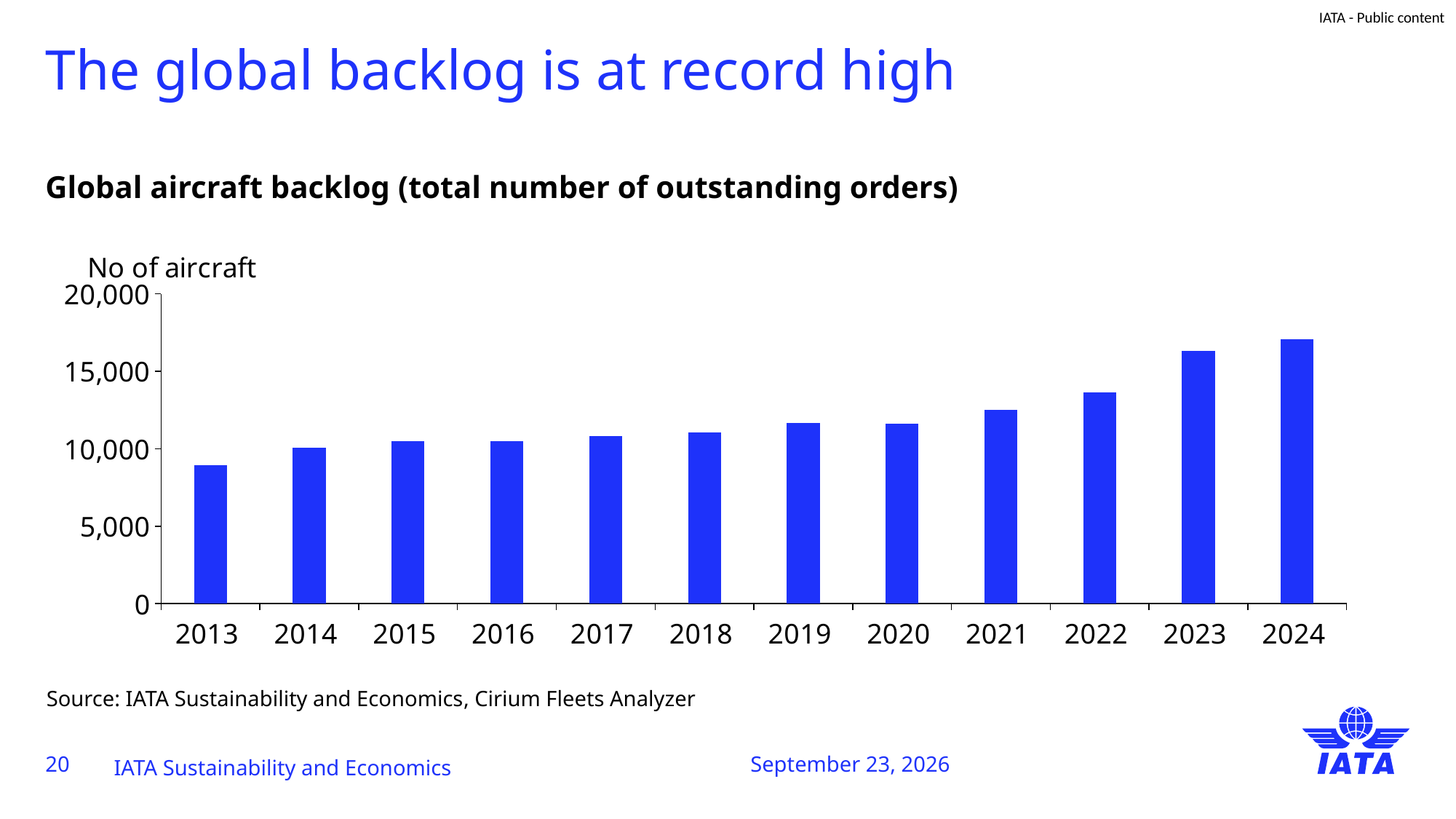
Do the values generally rise or fall from 2013 to 2024? Rise Which year has the highest global aircraft backlog? 2024 Which year has the lowest global aircraft backlog? 2013 How many years are shown on the x axis of the chart? 12 What is the label on the vertical axis of the chart? No of aircraft Is the value for 2022 greater or less than 15,000? less Is the value for 2021 greater or less than 10,000? greater Which year has a larger backlog, 2013 or 2021? 2021 Is the value for 2013 greater or less than 10,000? less What kind of chart is shown on the slide? Bar chart Which year has a larger backlog, 2023 or 2022? 2023